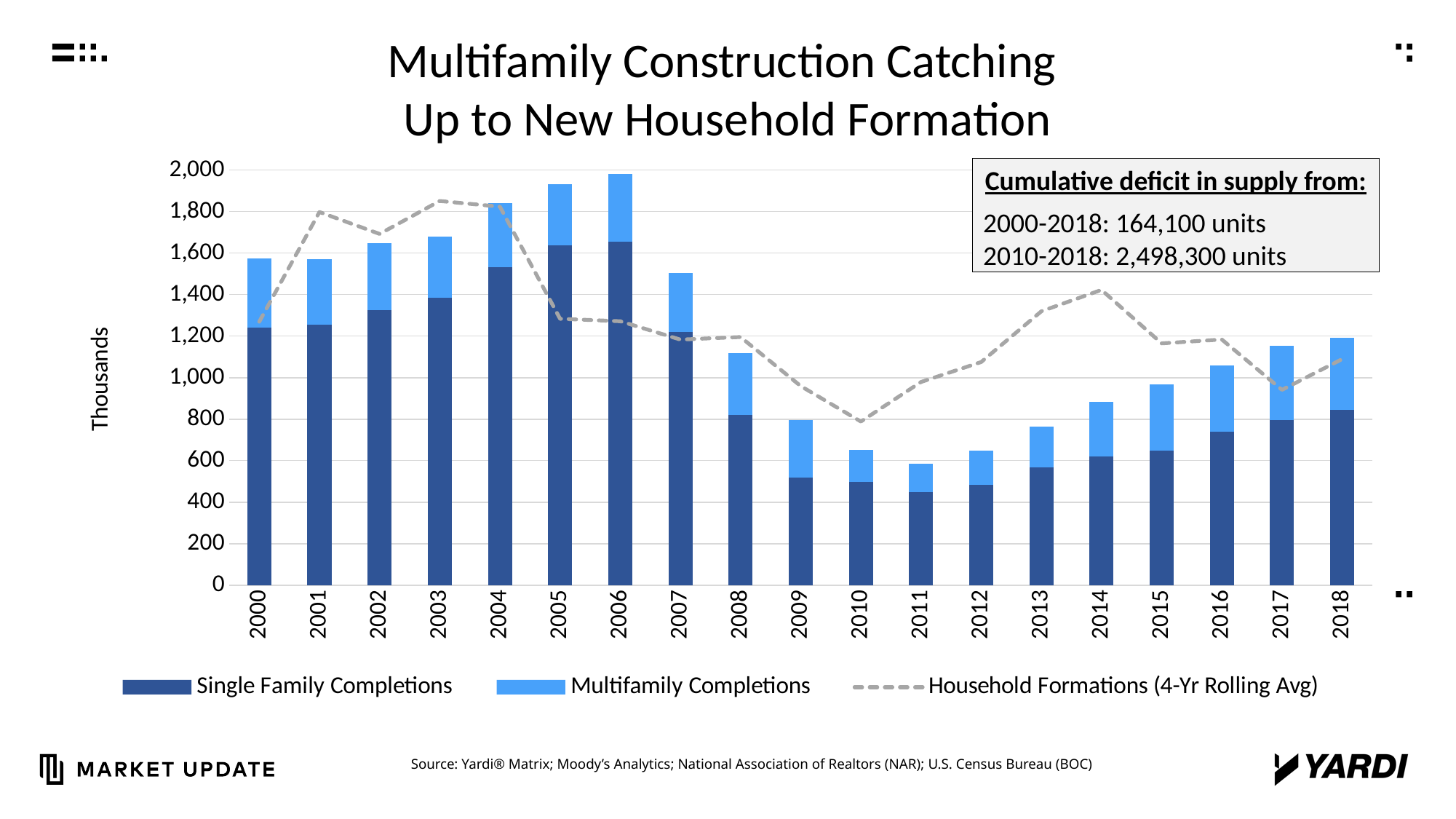
Do total completions rise or fall from 2011 to 2018? rise Is the Single Family Completions value for 2009 greater or less than 600? less Which year has the highest total completions (single family plus multifamily)? 2006 Which year has the lowest total completions (single family plus multifamily)? 2011 Is the total completions value for 2010 greater or less than 800? less Which series is shown as a dashed grey line? Household Formations (4-Yr Rolling Avg) Which is larger, the Household Formations (4-Yr Rolling Avg) value in 2014 or in 2010? 2014 Is the total completions value for 2006 greater or less than 1,800? greater How many years are shown on the x axis? 19 According to the text box, what is the cumulative deficit in supply from 2010-2018? 2,498,300 units What kind of chart is shown on the slide? combination bar and line chart How many series does the legend list? 3